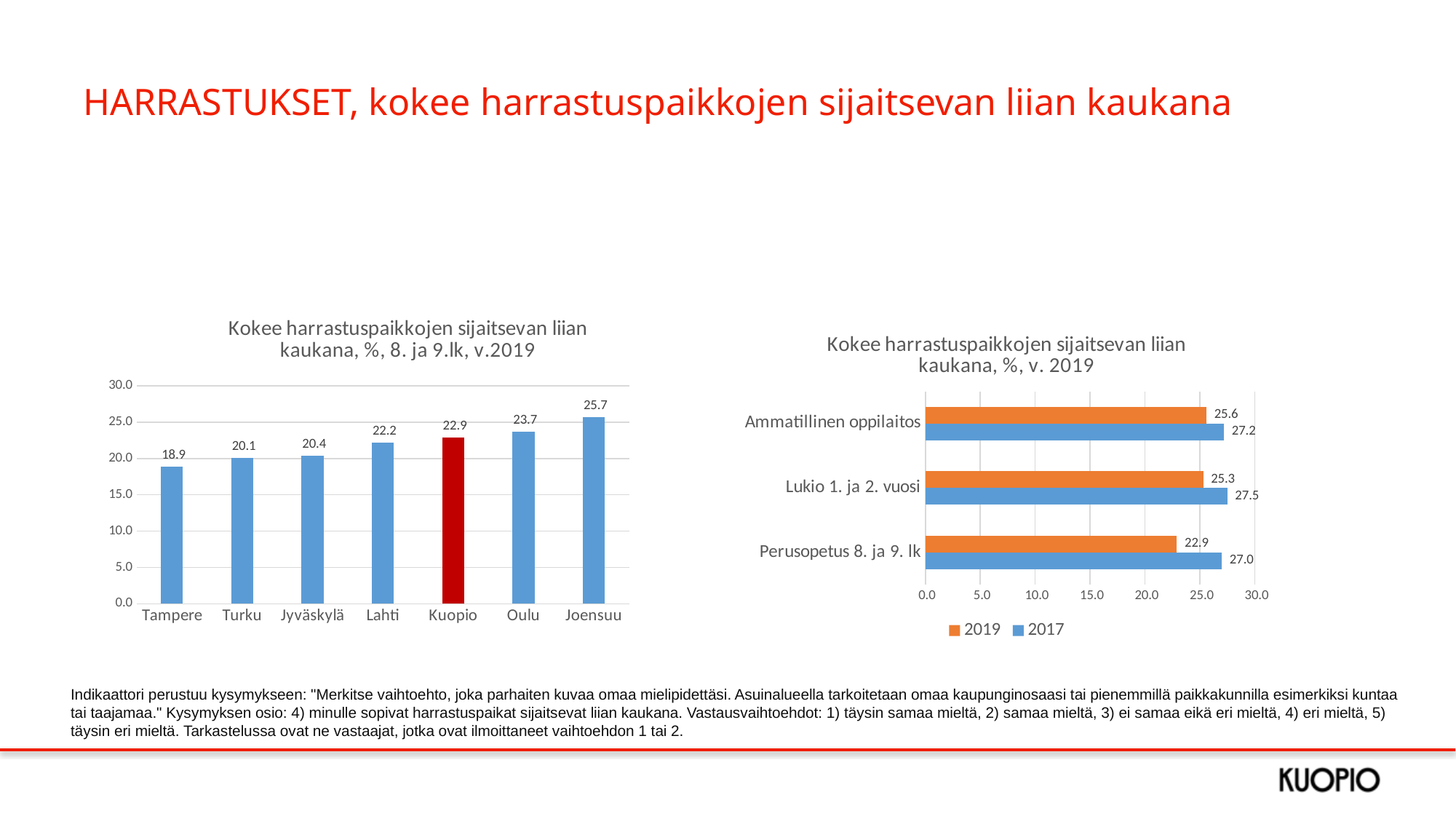
In the right chart, what is the difference between the 2017 and 2019 values for Perusopetus 8. ja 9. lk? 4.1 In the right chart (Kokee harrastuspaikkojen sijaitsevan liian kaukana, %, v. 2019), what is the 2017 value for Lukio 1. ja 2. vuosi? 27.5 How many series does the legend of the right chart list? 2 In the left chart (Kokee harrastuspaikkojen sijaitsevan liian kaukana, %, 8. ja 9.lk, v.2019), what is the value for Kuopio? 22.9 In the left chart, which is larger, the value for Oulu or the value for Lahti? Oulu What kind of chart is the left chart? Bar chart How many cities are shown in the left chart? 7 In the left chart, do the values rise or fall from Tampere to Joensuu along the x axis? Rise In the left chart, which city has the lowest value? Tampere In the left chart, which city has the highest value? Joensuu In the left chart, what is the difference between the values for Joensuu and Tampere? 6.8 In the left chart, which bar is coloured red instead of blue? Kuopio